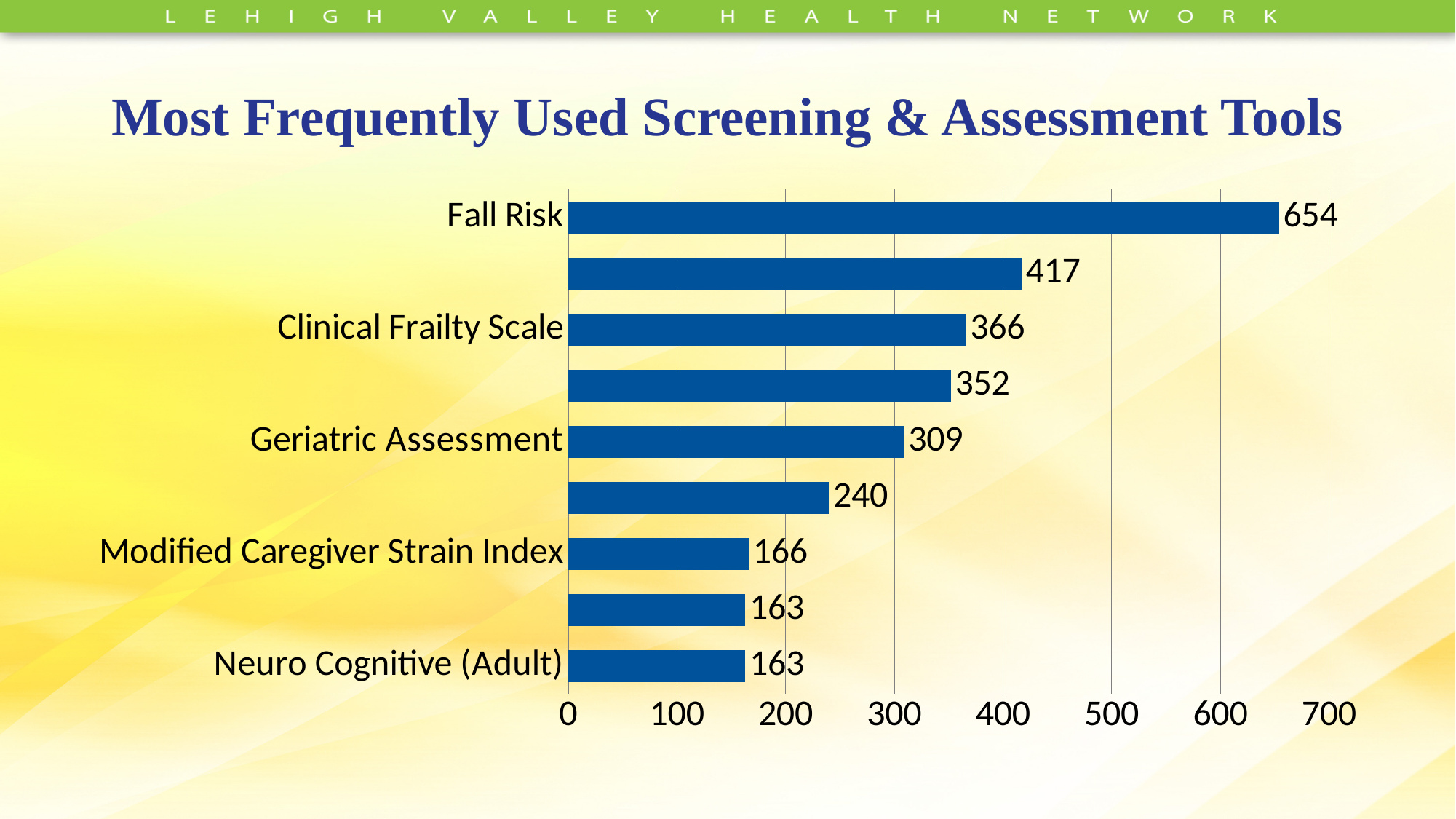
What is the difference between the values for Geriatric Assessment and Modified Caregiver Strain Index? 143 What is the difference between the values for Fall Risk and Clinical Frailty Scale? 288 What is the value for Fall Risk? 654 Which labeled tool has the highest value? Fall Risk Which is larger, the value for Clinical Frailty Scale or the value for Geriatric Assessment? Clinical Frailty Scale What is the value for Geriatric Assessment? 309 What is the value for Clinical Frailty Scale? 366 What is the value for Neuro Cognitive (Adult)? 163 How many bars are plotted in the chart? 9 What is the title of the slide? Most Frequently Used Screening & Assessment Tools What kind of chart is shown on the slide? bar chart What is the value for Modified Caregiver Strain Index? 166